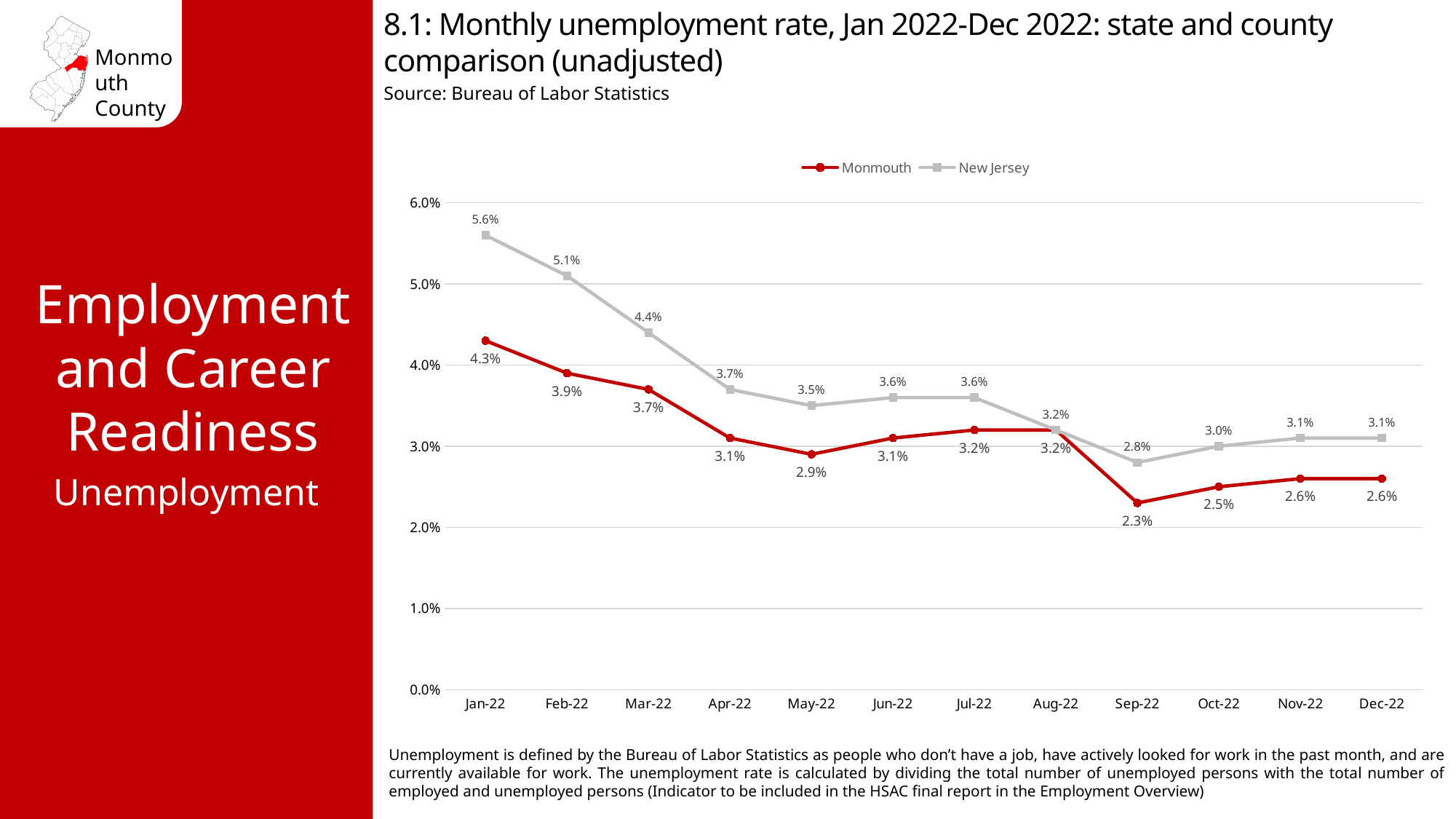
What was the Monmouth unemployment rate in Jan-22? 4.3% What was the Monmouth unemployment rate in Sep-22? 2.3% Which had the higher unemployment rate in Mar-22, Monmouth or New Jersey? New Jersey What kind of chart is shown on the slide? Line chart How many series does the legend list? 2 What was the New Jersey unemployment rate in May-22? 3.5% How many months are plotted on the x axis? 12 What is the difference between the New Jersey and Monmouth unemployment rates in Jan-22? 1.3% In which month was the Monmouth unemployment rate lowest? Sep-22 What is the difference between the New Jersey and Monmouth unemployment rates in Dec-22? 0.5% In which month was the New Jersey unemployment rate highest? Jan-22 Did the New Jersey unemployment rate generally rise or fall from Jan-22 to Sep-22? Fall